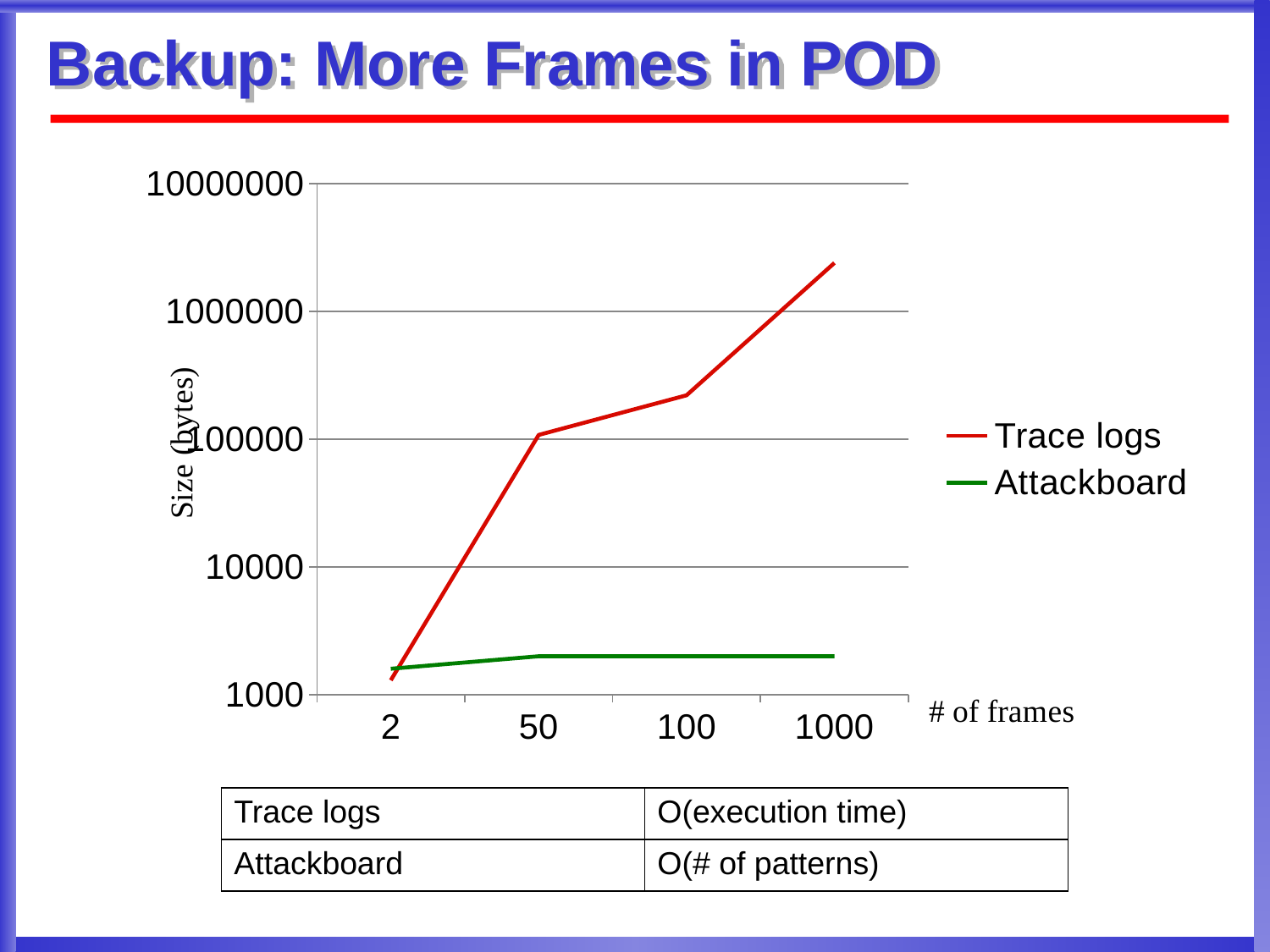
Is the Trace logs value at 100 frames greater or less than 100000? greater Is the Attackboard value at 1000 frames greater or less than 10000? less What kind of chart is shown on the slide? line chart Does the Trace logs series rise or fall as the number of frames increases? rise At which number of frames does the Trace logs series reach its highest size? 1000 At 1000 frames, which series has the larger size, Trace logs or Attackboard? Trace logs Is the Trace logs value at 1000 frames greater or less than 1000000? greater Which series is drawn in red? Trace logs What is the label of the y axis? Size (bytes) How many series does the legend list? 2 How many values of # of frames are plotted along the x axis? 4